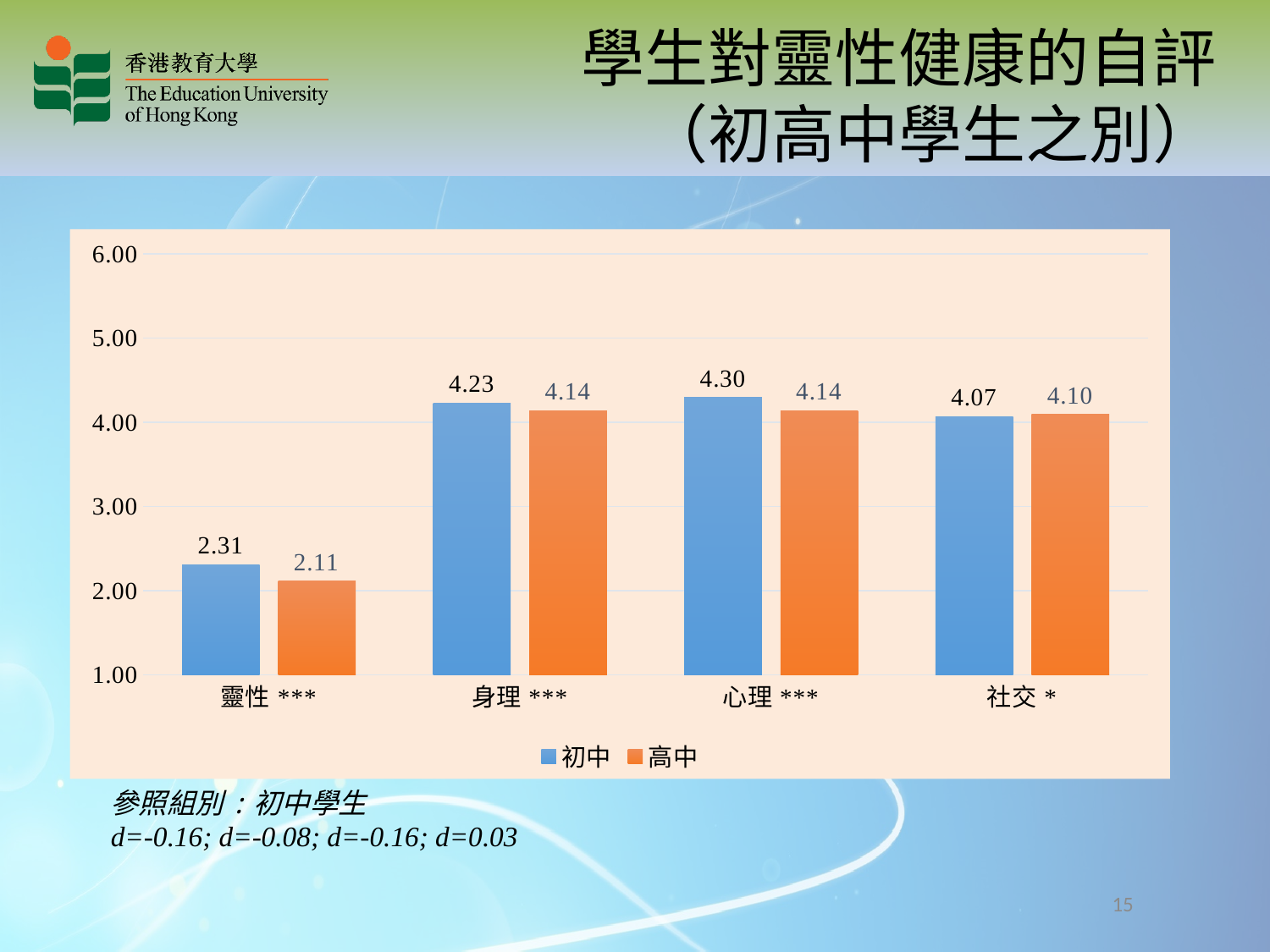
What is the value for 高中 in the 心理 *** category? 4.14 What is the difference between the 初中 and 高中 values in the 靈性 *** category? 0.20 Is the value for 初中 in the 身理 *** category greater or less than 4.00? greater Which is larger in the 社交 * category, the 初中 value or the 高中 value? 高中 Which category has the highest value for the 初中 series? 心理 *** What kind of chart is shown on the slide? bar chart What is the value for 初中 in the 靈性 *** category? 2.31 Which category has the lowest value for the 高中 series? 靈性 *** What is the value for 高中 in the 社交 * category? 4.10 How many categories are shown on the x axis? 4 How many series does the legend list? 2 What is the difference between the 初中 and 高中 values in the 心理 *** category? 0.16